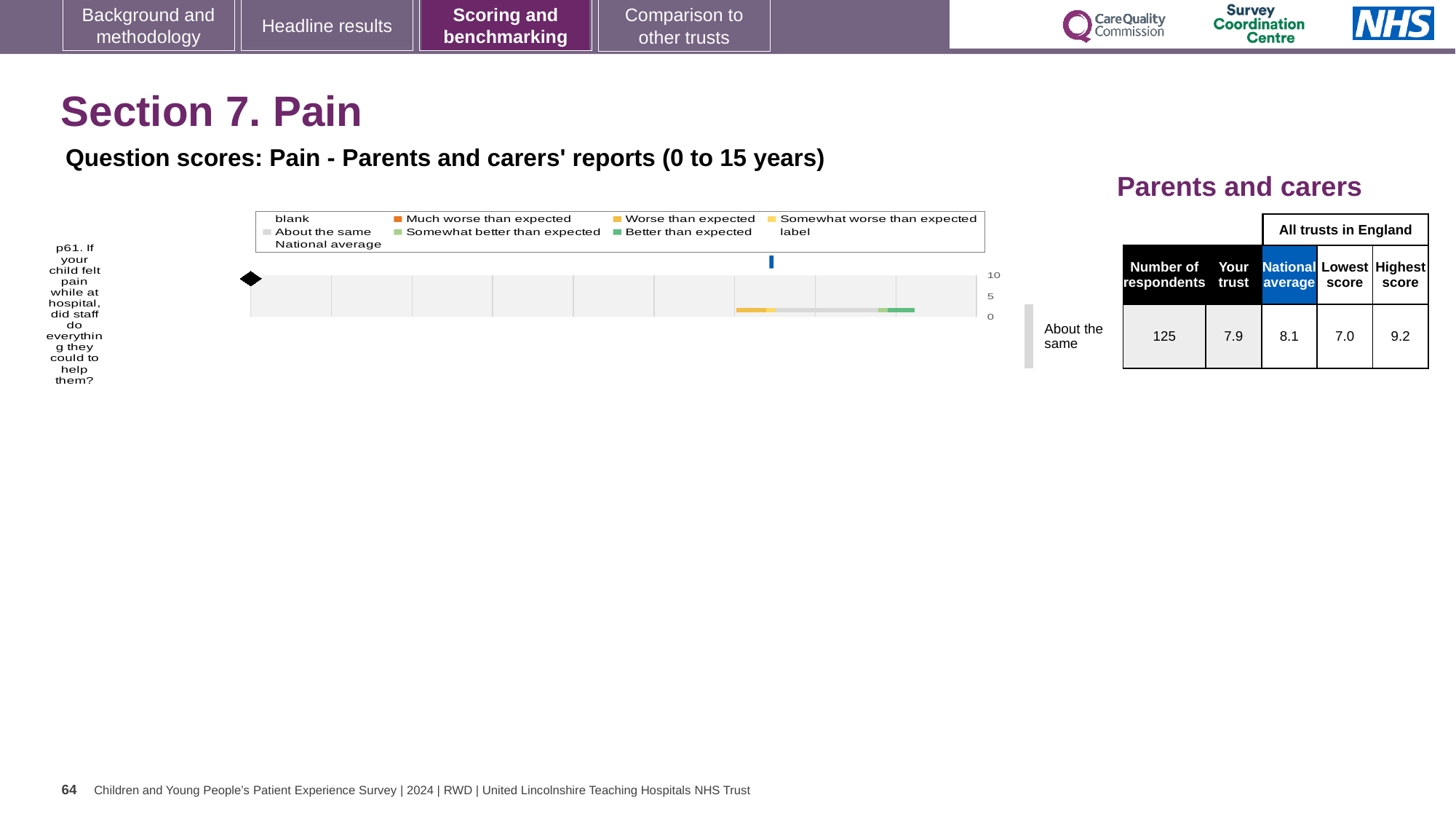
What is the lowest score among all trusts in England for question p61? 7.0 Is the national average marker on the chart greater or less than 5? greater Which benchmarking category is the trust's result for question p61 assigned to? About the same What kind of chart is shown on the slide? bar chart What is the national average score for question p61? 8.1 How many questions (categories) are plotted in the chart? 1 How many respondents answered question p61? 125 What is the 'Your trust' score for question p61 shown in the table beside the chart? 7.9 What is the difference between the highest score and the lowest score for question p61? 2.2 Which is larger for question p61: the national average or the 'Your trust' score? National average How many entries does the chart legend list? 9 What is the highest score among all trusts in England for question p61? 9.2